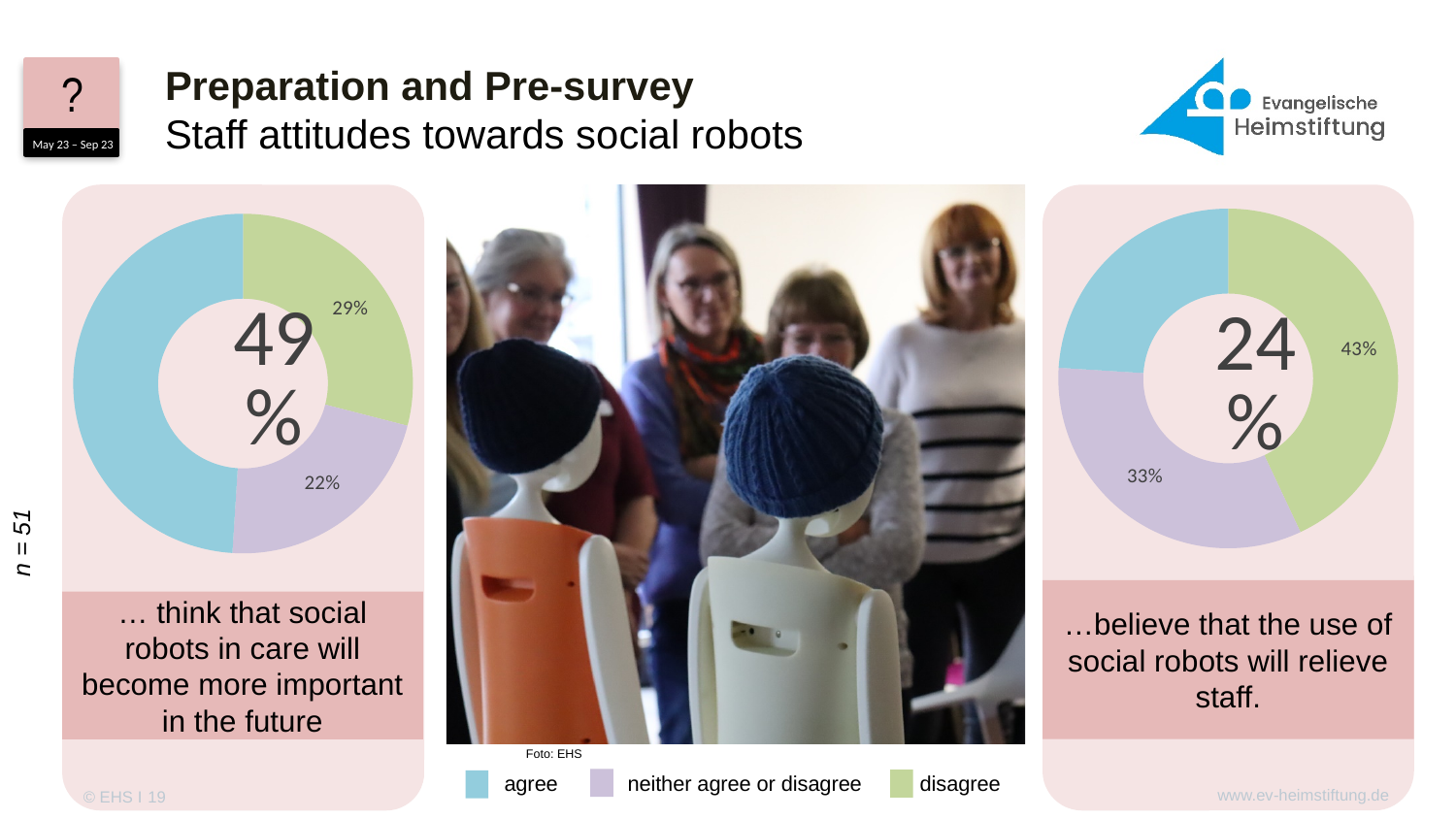
In the left donut chart (social robots will become more important), what share of staff disagree? 29% In the right donut chart (social robots will relieve staff), what share of staff disagree? 43% In the right donut chart (social robots will relieve staff), what share neither agree nor disagree? 33% What type of chart is used on this slide? donut (pie) chart Which chart has the larger agree share, the left one or the right one? the left one In the left donut chart, which response category has the largest share? agree In the left donut chart (social robots will become more important), what share of staff agree? 49% In the left donut chart, what is the difference between the agree share and the disagree share? 20% In the right donut chart, which response category has the smallest share? agree In the right donut chart (social robots will relieve staff), what share of staff agree? 24% In the left donut chart (social robots will become more important), what share neither agree nor disagree? 22% How many response categories does the legend list? 3